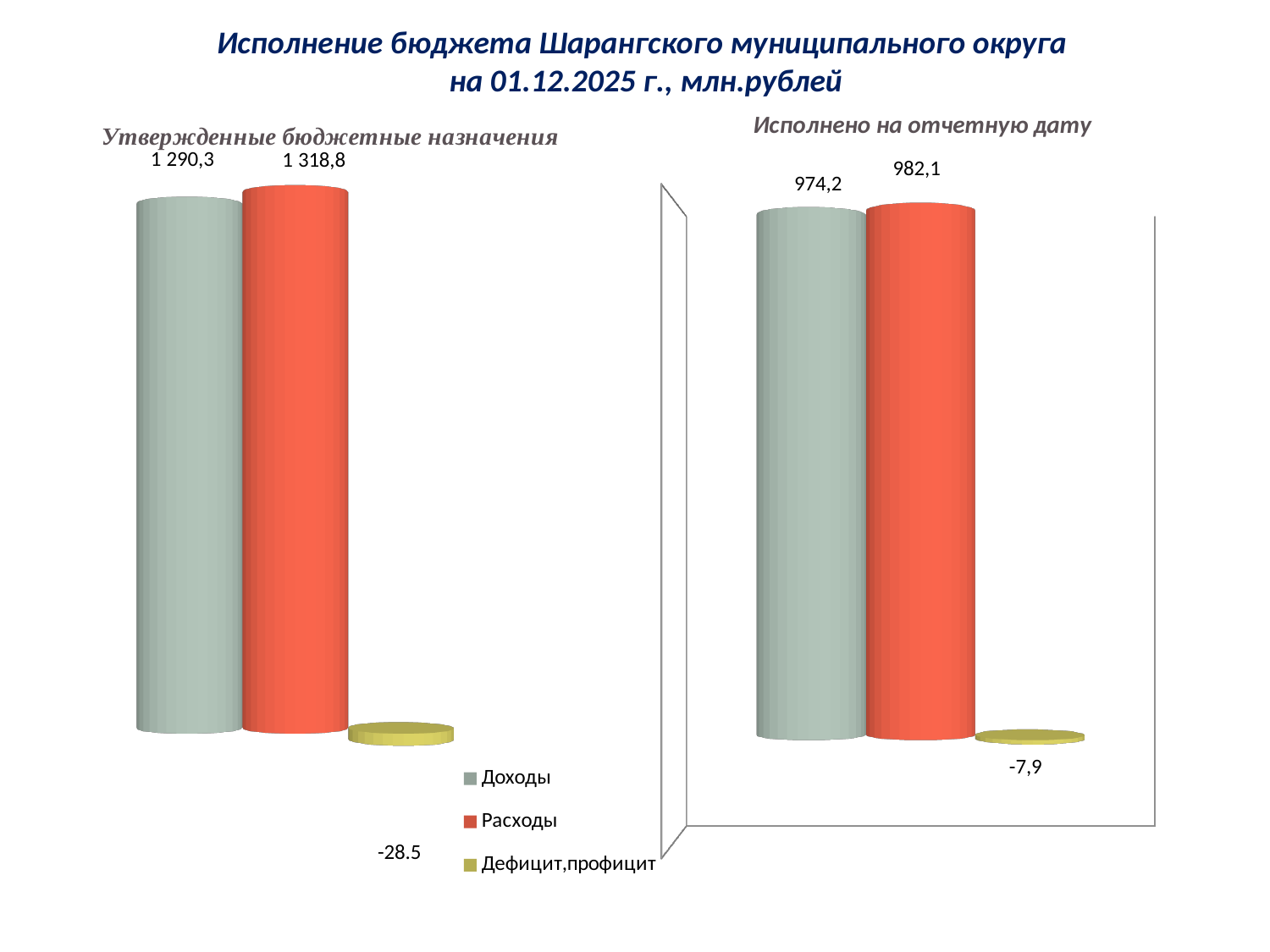
On the chart titled 'Утвержденные бюджетные назначения', which is larger, Доходы or Расходы? Расходы On the chart titled 'Исполнено на отчетную дату', what is the value for Расходы? 982,1 On the chart titled 'Утвержденные бюджетные назначения', which series has the lowest value? Дефицит,профицит On the chart titled 'Исполнено на отчетную дату', what is the value for Доходы? 974,2 On the chart titled 'Утвержденные бюджетные назначения', what is the value for Доходы? 1 290,3 On the chart titled 'Исполнено на отчетную дату', what is the difference between Расходы and Доходы? 7,9 On the chart titled 'Исполнено на отчетную дату', which series has the highest value? Расходы On the chart titled 'Исполнено на отчетную дату', what is the value for Дефицит,профицит? -7,9 What kind of chart is the chart titled 'Исполнено на отчетную дату'? Bar chart On the chart titled 'Утвержденные бюджетные назначения', what is the value for Дефицит,профицит? -28.5 How many series does the legend list? 3 On the chart titled 'Утвержденные бюджетные назначения', what is the value for Расходы? 1 318,8